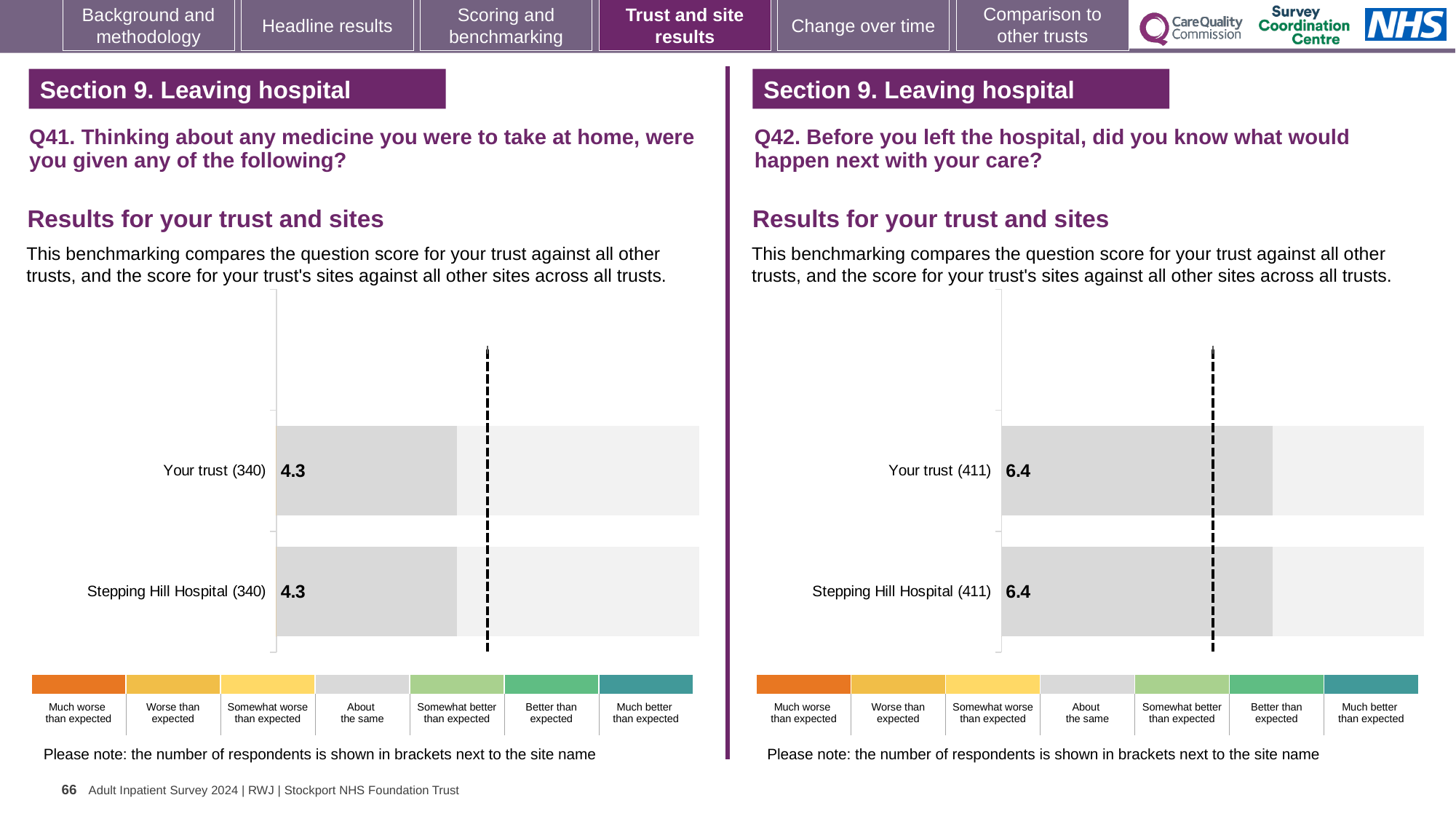
In the Q41 chart on the left, what is the score for Your trust? 4.3 In the Q41 chart on the left, how many respondents are shown in brackets next to Your trust? 340 In the Q41 chart on the left, what is the difference between the Your trust score and the Stepping Hill Hospital score? 0 In the Q41 chart on the left, what is the score for Stepping Hill Hospital? 4.3 How many bars are plotted in the Q41 chart on the left? 2 In the Q42 chart on the right, what is the score for Your trust? 6.4 In the Q42 chart on the right, what is the score for Stepping Hill Hospital? 6.4 What kind of chart is used for the Q42 results on the right? Bar chart How many bars are plotted in the Q42 chart on the right? 2 In the Q42 chart on the right, what is the difference between the Your trust score and the Stepping Hill Hospital score? 0 How many categories does the colour key below the Q41 chart on the left list? 7 In the Q42 chart on the right, how many respondents are shown in brackets next to Stepping Hill Hospital? 411